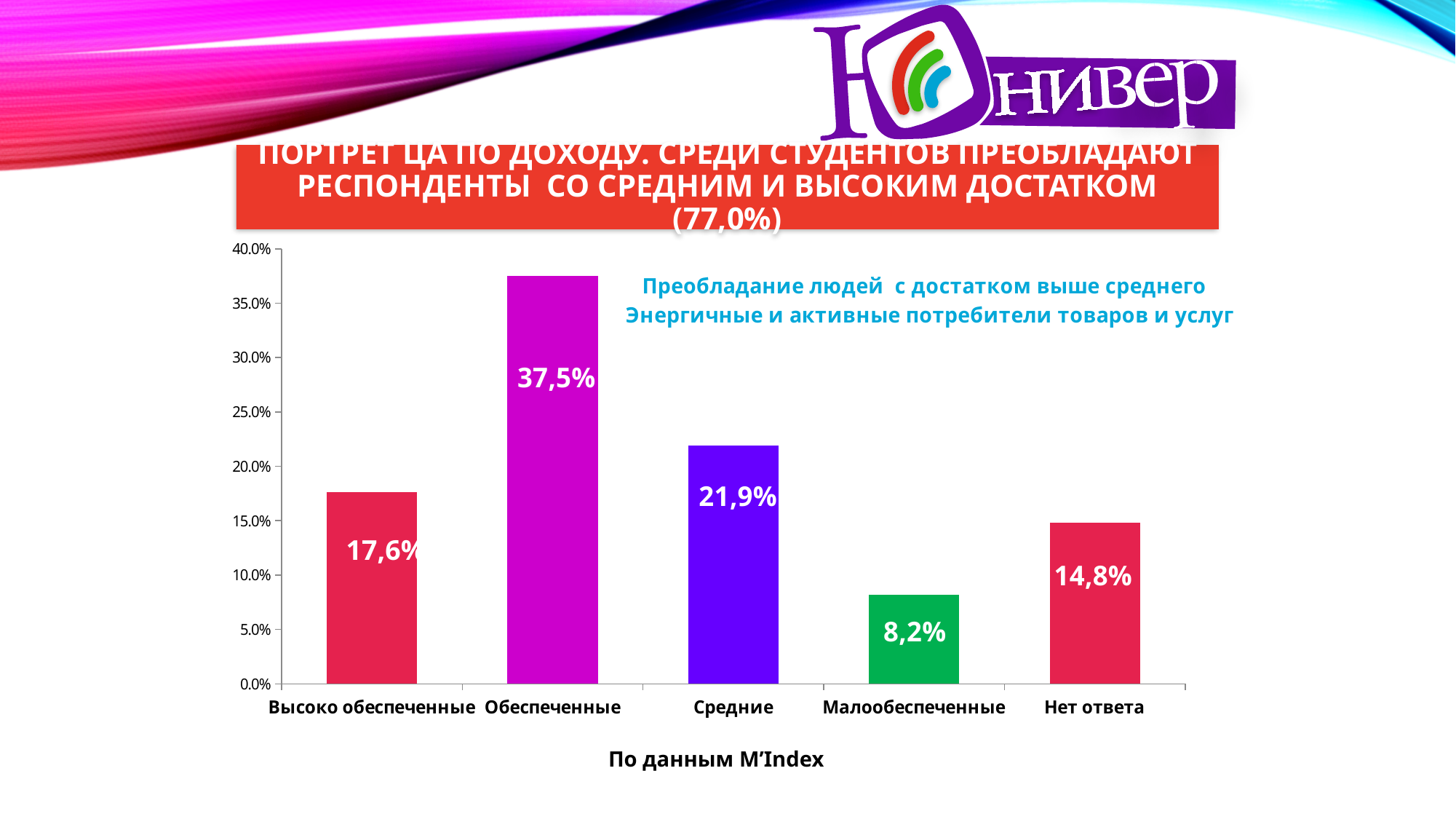
How many categories are shown on the x axis? 5 Which category has the lowest value? Малообеспеченные What is the difference between the values for Высоко обеспеченные and Нет ответа? 2,8% What is the value for Нет ответа? 14,8% Which is larger, the value for Средние or the value for Высоко обеспеченные? Средние What kind of chart is shown on the slide? bar chart Which category has the highest value? Обеспеченные What is the difference between the values for Обеспеченные and Средние? 15,6% What is the value for Высоко обеспеченные? 17,6% Is the value for Средние greater or less than 20.0%? greater What is the value for Малообеспеченные? 8,2% What is the value for Обеспеченные? 37,5%